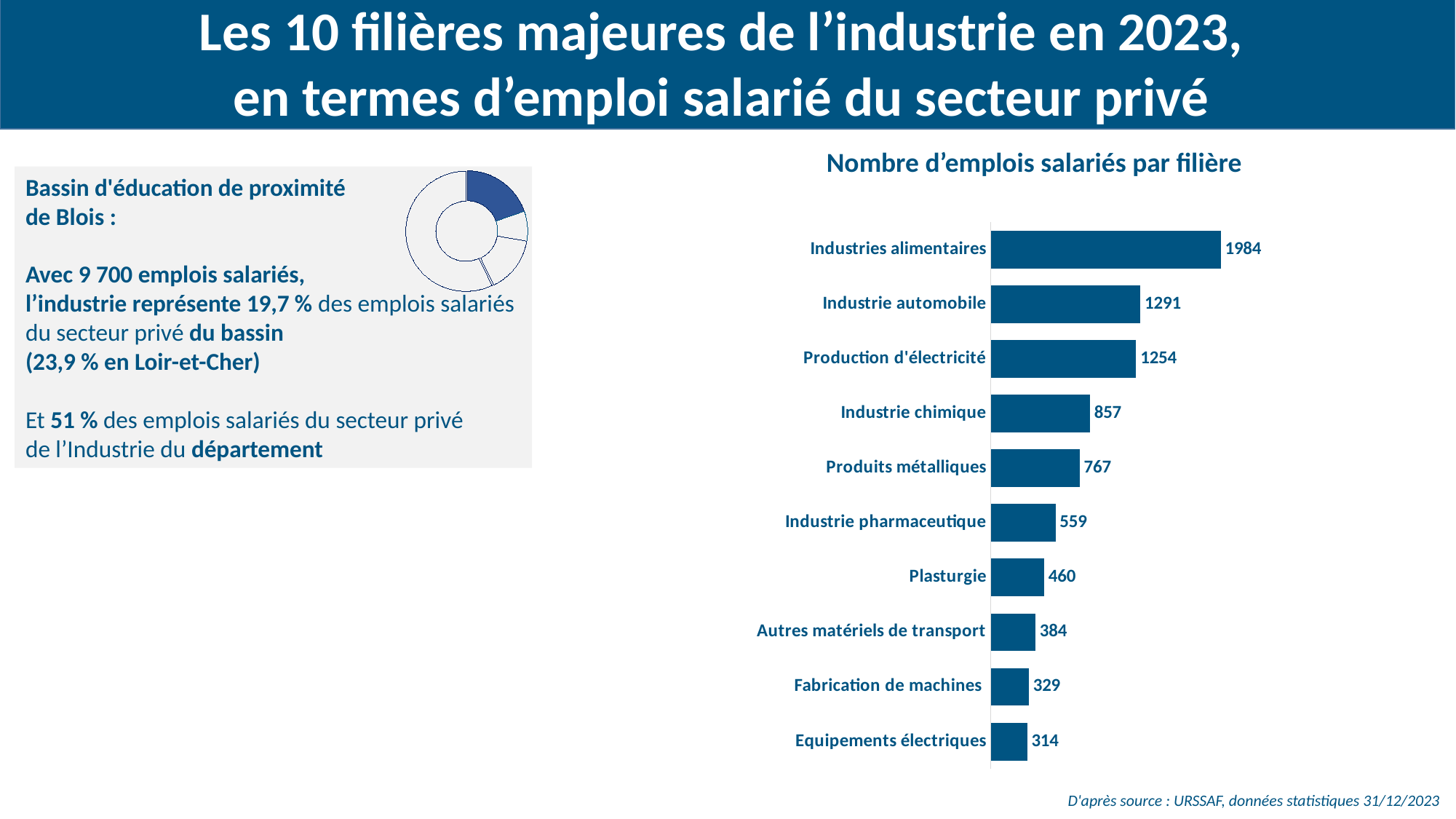
In the chart 'Nombre d'emplois salariés par filière', which is larger: Industrie automobile or Production d'électricité? Industrie automobile In the chart 'Nombre d'emplois salariés par filière', what is the difference between Industries alimentaires and Industrie automobile? 693 How many filières are shown in the chart 'Nombre d'emplois salariés par filière'? 10 In the chart 'Nombre d'emplois salariés par filière', what is the value for Plasturgie? 460 In the chart 'Nombre d'emplois salariés par filière', which filière has the highest number of salaried jobs? Industries alimentaires What kind of chart is 'Nombre d'emplois salariés par filière'? Bar chart In the chart 'Nombre d'emplois salariés par filière', what is the value for Industrie pharmaceutique? 559 What is the title of the chart on the right side of the slide? Nombre d'emplois salariés par filière In the chart 'Nombre d'emplois salariés par filière', which is larger: Autres matériels de transport or Fabrication de machines? Autres matériels de transport In the chart 'Nombre d'emplois salariés par filière', what is the difference between Industrie chimique and Produits métalliques? 90 In the chart 'Nombre d'emplois salariés par filière', which filière has the lowest number of salaried jobs? Equipements électriques In the chart 'Nombre d'emplois salariés par filière', what is the value for Industrie automobile? 1291